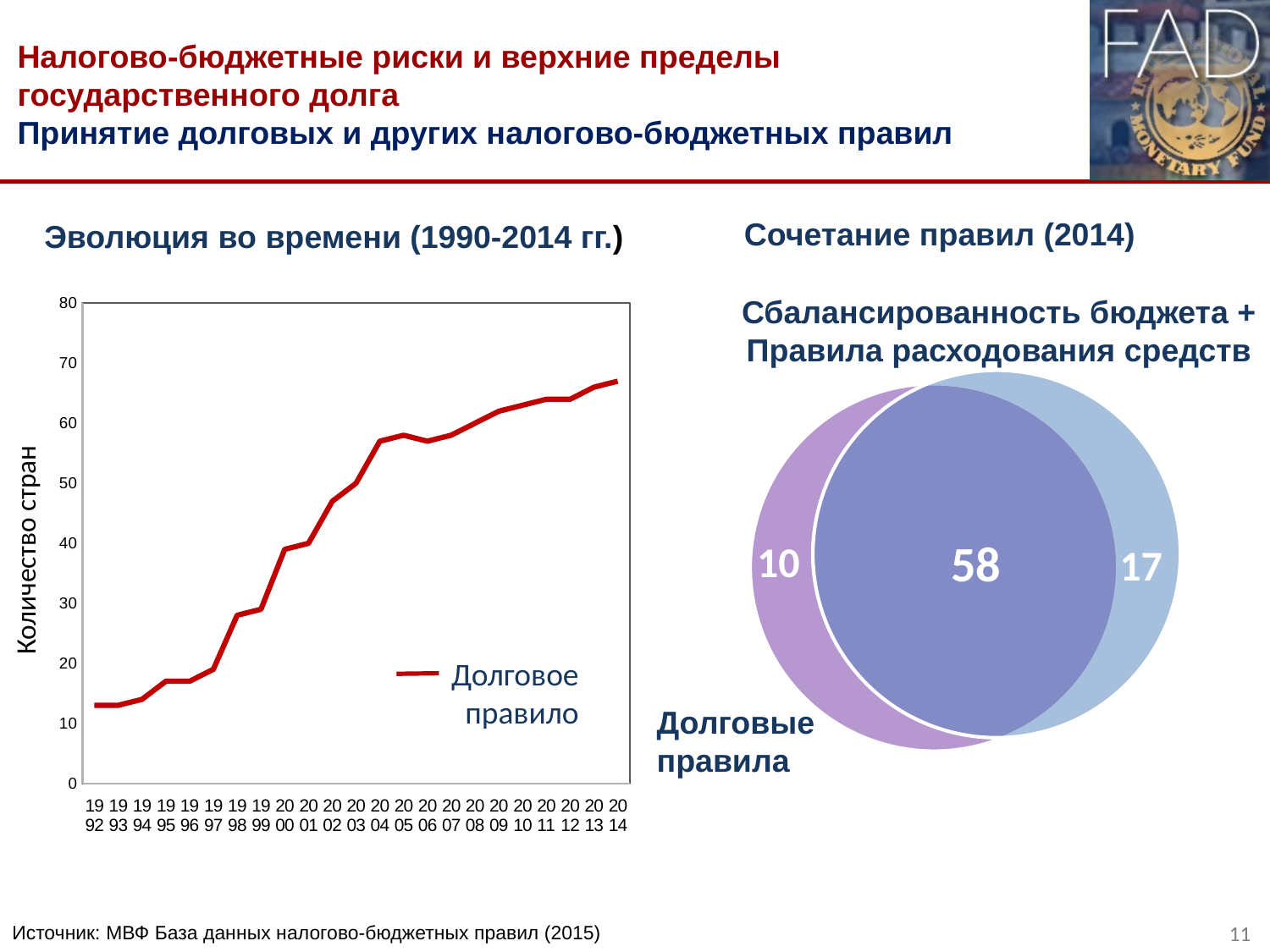
In the 'Эволюция во времени' chart, do the values rise or fall from 1992 to 2014? rise In the 'Эволюция во времени' chart, is the value for 1992 greater or less than 20? less In the 'Эволюция во времени' chart, what is the label of the vertical axis? Количество стран In the 'Эволюция во времени' chart, which year has the larger value, 1998 or 2004? 2004 In the 'Эволюция во времени' chart, what is the name of the series shown in the legend? Долговое правило In the 'Сочетание правил (2014)' diagram on the right, how many countries are in the overlap of the two circles? 58 In the 'Эволюция во времени' chart, is the value for 2004 greater or less than 50? greater In the 'Эволюция во времени' chart, how many series does the legend list? 1 In the 'Эволюция во времени' chart, how many years are shown on the x axis? 23 In the 'Эволюция во времени' chart, is the value for 2014 greater or less than 60? greater In the 'Эволюция во времени' chart, which year has the highest value? 2014 What kind of chart is the 'Эволюция во времени (1990-2014 гг.)' chart on the left? line chart